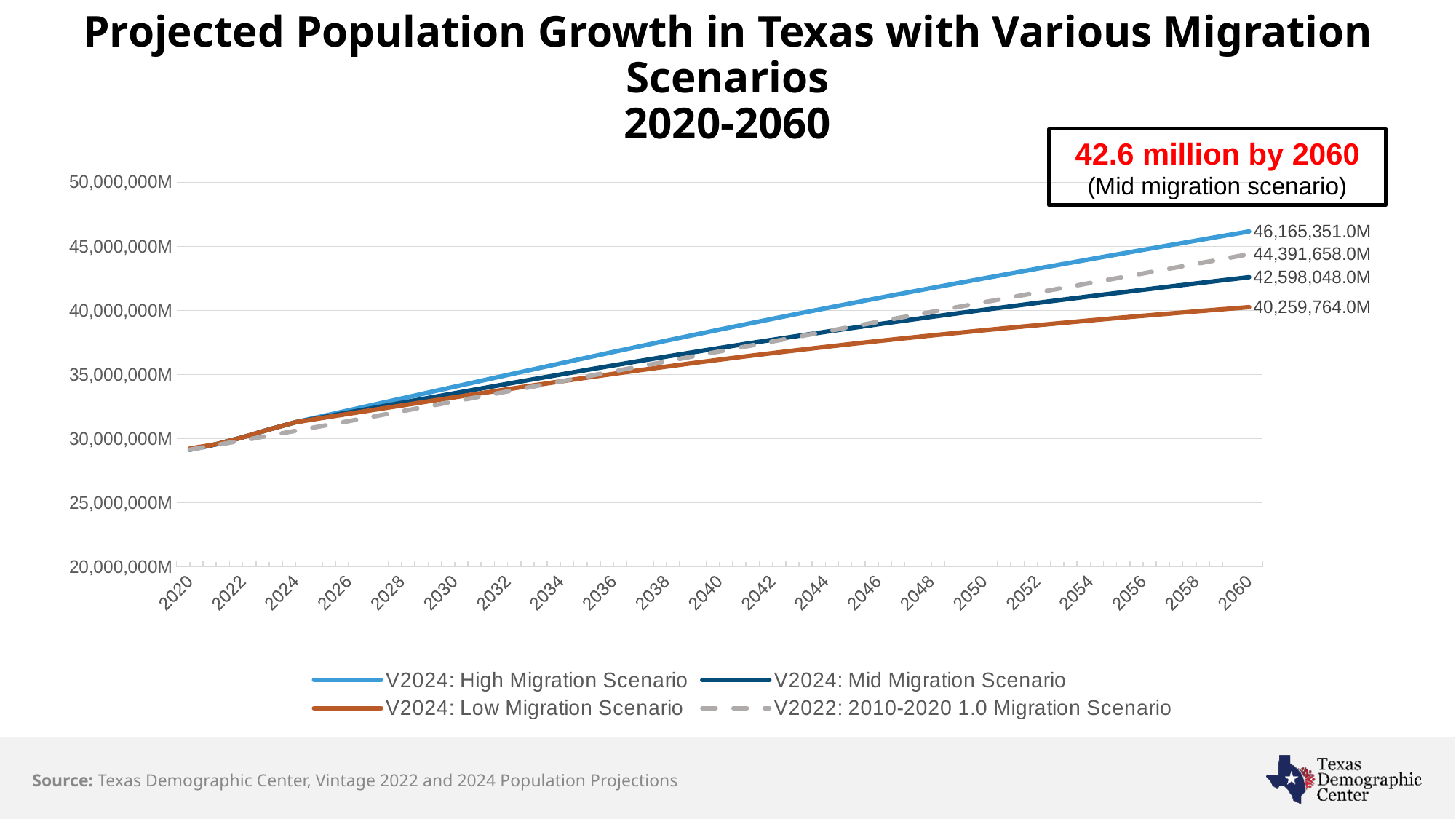
What kind of chart is shown on the slide? line chart Is the value for the V2024: Low Migration Scenario in 2050 greater or less than 40,000,000M? less Which series has the highest value in 2060? V2024: High Migration Scenario What is the 2060 value for the V2024: Mid Migration Scenario series? 42,598,048.0M What is the 2060 value for the V2022: 2010-2020 1.0 Migration Scenario series? 44,391,658.0M What is the difference between the 2060 values of the V2024 High Migration Scenario and the V2024 Low Migration Scenario? 5,905,587.0M Do the values of the V2024: Mid Migration Scenario rise or fall from 2020 to 2060? rise How many series does the legend list? 4 What is the 2060 value for the V2024: High Migration Scenario series? 46,165,351.0M What is the 2060 value for the V2024: Low Migration Scenario series? 40,259,764.0M In 2060, which is larger: the V2022: 2010-2020 1.0 Migration Scenario or the V2024: Mid Migration Scenario? V2022: 2010-2020 1.0 Migration Scenario Which series has the lowest value in 2060? V2024: Low Migration Scenario